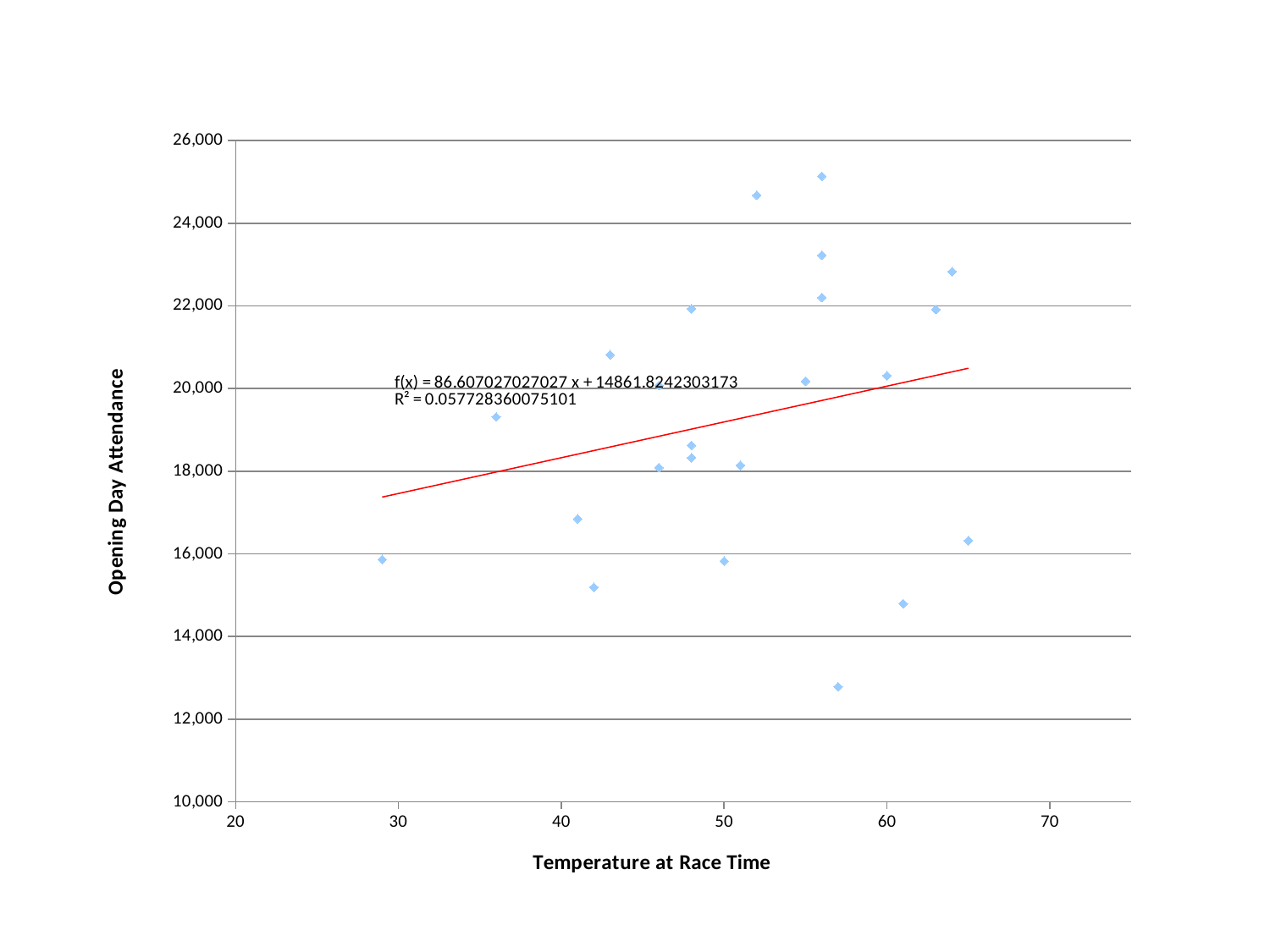
Is the attendance of the point at the highest temperature (near 65) greater or less than 18,000? less Is the attendance of the highest point on the chart greater or less than 24,000? greater What kind of chart is shown on the slide? scatter plot Does the red trendline rise or fall as temperature increases? rise Is the attendance of the lowest point on the chart greater or less than 14,000? less What is the title of the y axis? Opening Day Attendance What is the R² value printed on the chart? 0.057728360075101 What is the trendline equation printed on the chart? f(x) = 86.607027027027 x + 14861.8242303173 What is the title of the x axis? Temperature at Race Time What is the highest value shown on the y axis? 26,000